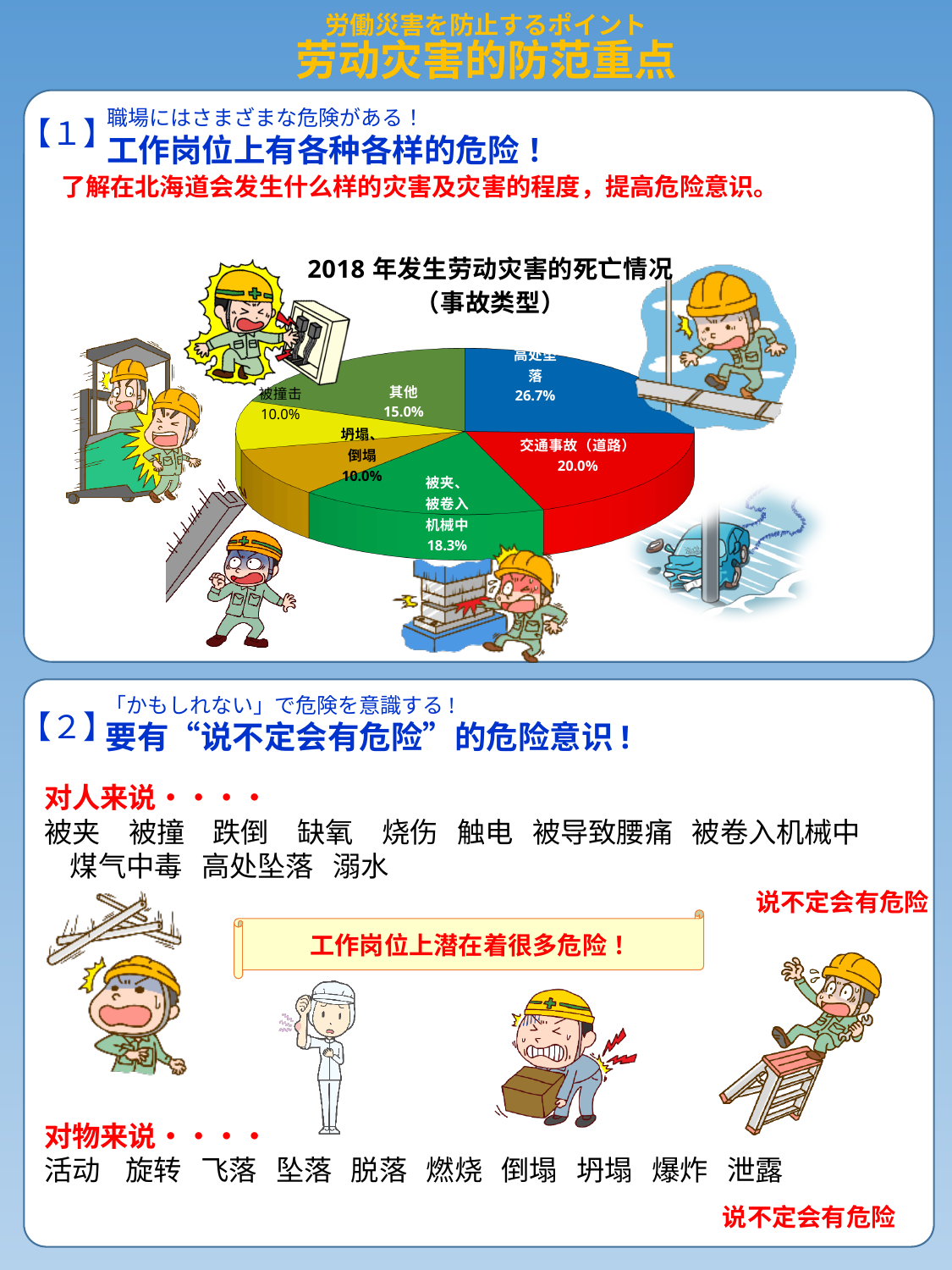
What type of chart is shown on the slide? pie chart What percentage of the pie chart is 高处坠落? 26.7% What is the difference in percentage points between 高处坠落 and 交通事故（道路）? 6.7 Which is larger, the share for 被夹、被卷入机械中 or the share for 其他? 被夹、被卷入机械中 What is the title of the pie chart? 2018 年发生劳动灾害的死亡情况（事故类型） What percentage of the pie chart is 被夹、被卷入机械中? 18.3% What percentage of the pie chart is 交通事故（道路）? 20.0% Which accident type has the largest share of the pie chart? 高处坠落 Which two accident types share the smallest slice of the pie chart? 坍塌、倒塌 and 被撞击 What is the combined share of 坍塌、倒塌 and 被撞击? 20.0% What percentage of the pie chart is 其他? 15.0% How many slices does the pie chart have? 6